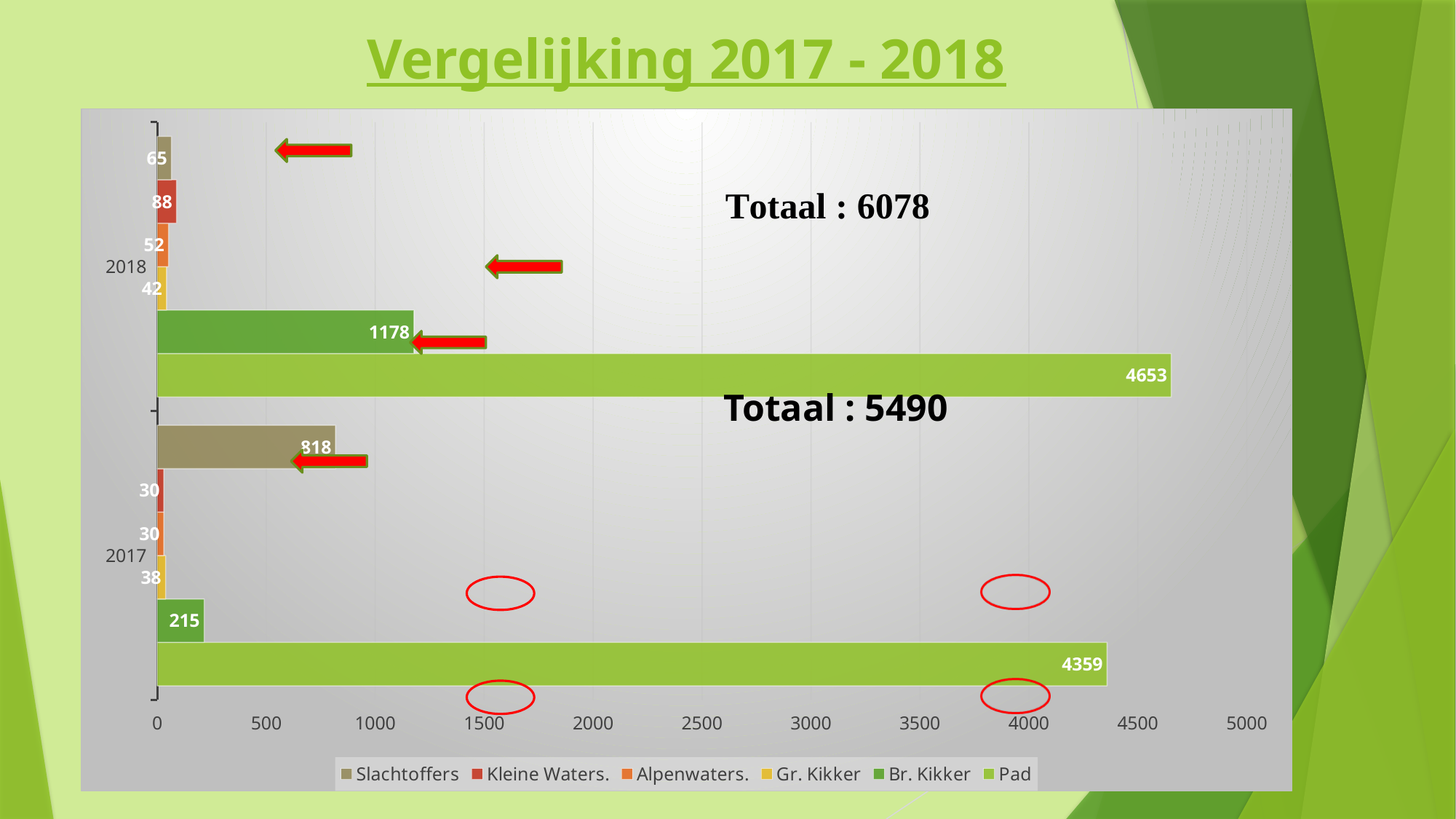
Which is larger, Br. Kikker in 2018 or Br. Kikker in 2017? Br. Kikker in 2018 What is the value for Slachtoffers in 2017? 818 What is the value for Gr. Kikker in 2017? 38 What is the title of the slide? Vergelijking 2017 - 2018 What is the difference between the Pad values for 2018 and 2017? 294 What type of chart is shown on the slide? bar chart What is the value for Br. Kikker in 2018? 1178 Which series has the lowest value in 2018? Gr. Kikker What is the value for Pad in 2018? 4653 How many series does the legend list? 6 How many year categories are shown on the vertical axis? 2 Which series has the highest value in 2017? Pad